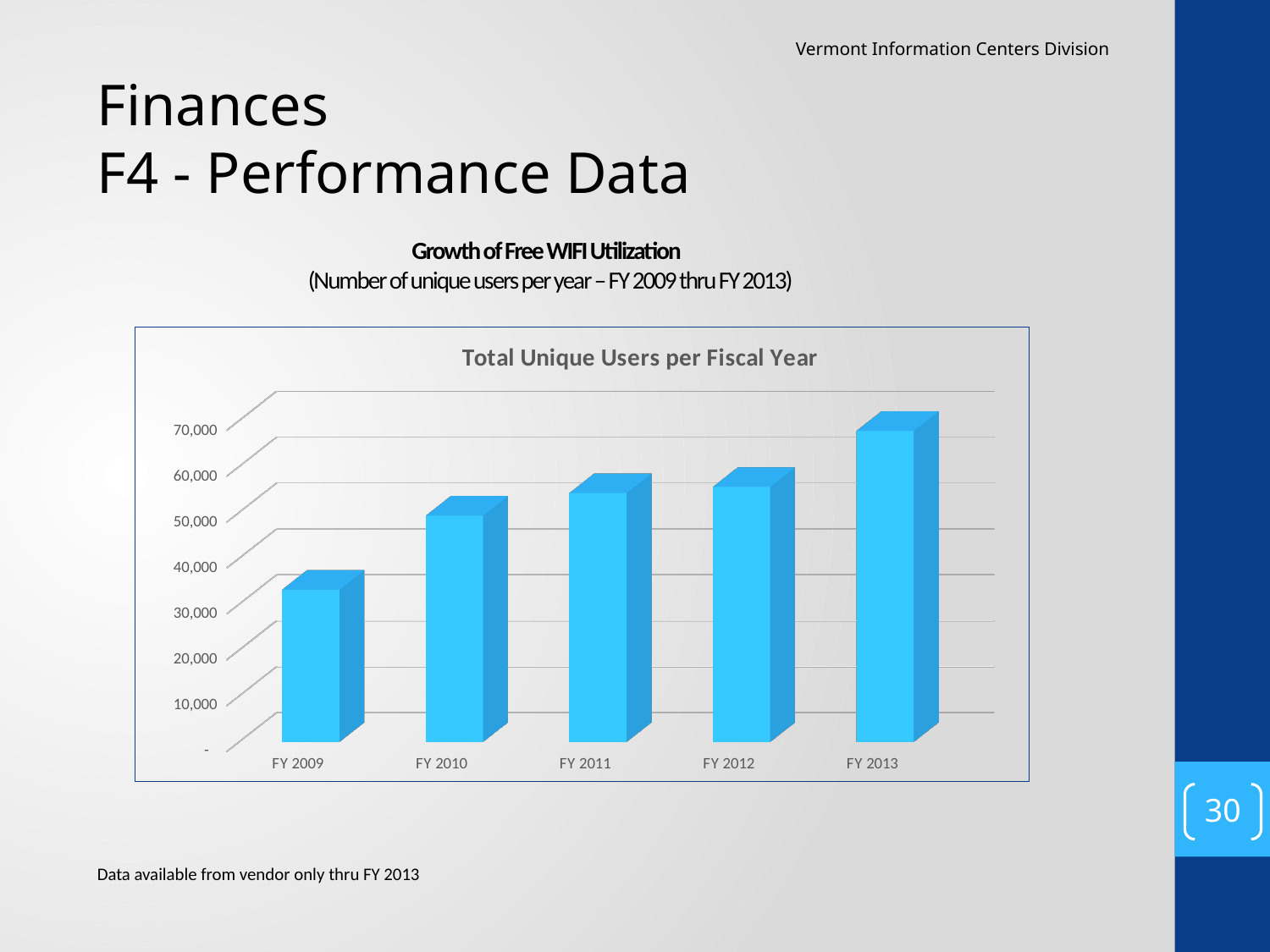
Is the value for FY 2012 greater or less than 60,000? less What is the title of the chart? Total Unique Users per Fiscal Year Which fiscal year has the highest number of unique users? FY 2013 Is the value for FY 2011 greater or less than 50,000? greater Is the value for FY 2010 greater or less than 40,000? greater Do the values rise or fall from FY 2009 to FY 2013? rise How many fiscal years are plotted in the chart? 5 Which fiscal year has the lowest number of unique users? FY 2009 Which is larger, the value for FY 2010 or the value for FY 2013? FY 2013 What kind of chart is shown on the slide? bar chart